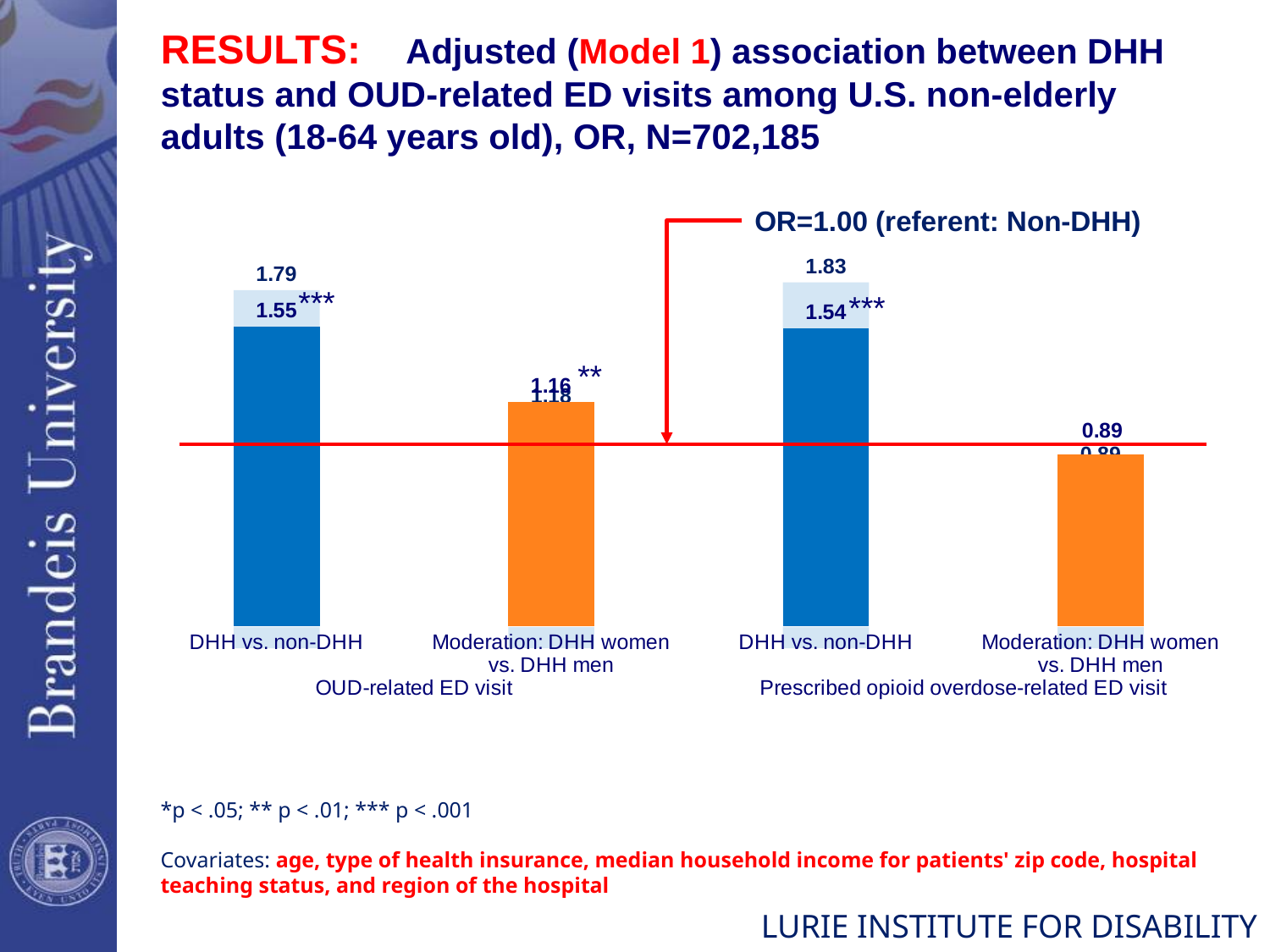
What is the odds ratio for DHH vs. non-DHH for OUD-related ED visit? 1.55 What significance level do the three asterisks (***) next to the DHH vs. non-DHH bars indicate? p < .001 What is the odds ratio for DHH vs. non-DHH for prescribed opioid overdose-related ED visit? 1.54 Which is larger: the odds ratio for DHH vs. non-DHH for OUD-related ED visit, or the moderation odds ratio for prescribed opioid overdose-related ED visit? DHH vs. non-DHH for OUD-related ED visit What is the odds ratio for the moderation (DHH women vs. DHH men) bar for prescribed opioid overdose-related ED visit? 0.89 What kind of chart is shown on the slide? Bar chart Is the moderation (DHH women vs. DHH men) odds ratio for prescribed opioid overdose-related ED visit greater or less than 1.00? less Is the moderation (DHH women vs. DHH men) odds ratio for OUD-related ED visit greater or less than 1.00? greater Which bar has the lowest odds ratio? Moderation: DHH women vs. DHH men, prescribed opioid overdose-related ED visit How many bars are plotted in the chart? 4 What is the difference between the DHH vs. non-DHH odds ratio for OUD-related ED visit (1.55) and the moderation odds ratio for prescribed opioid overdose-related ED visit (0.89)? 0.66 What value does the red horizontal reference line represent? OR=1.00 (referent: Non-DHH)